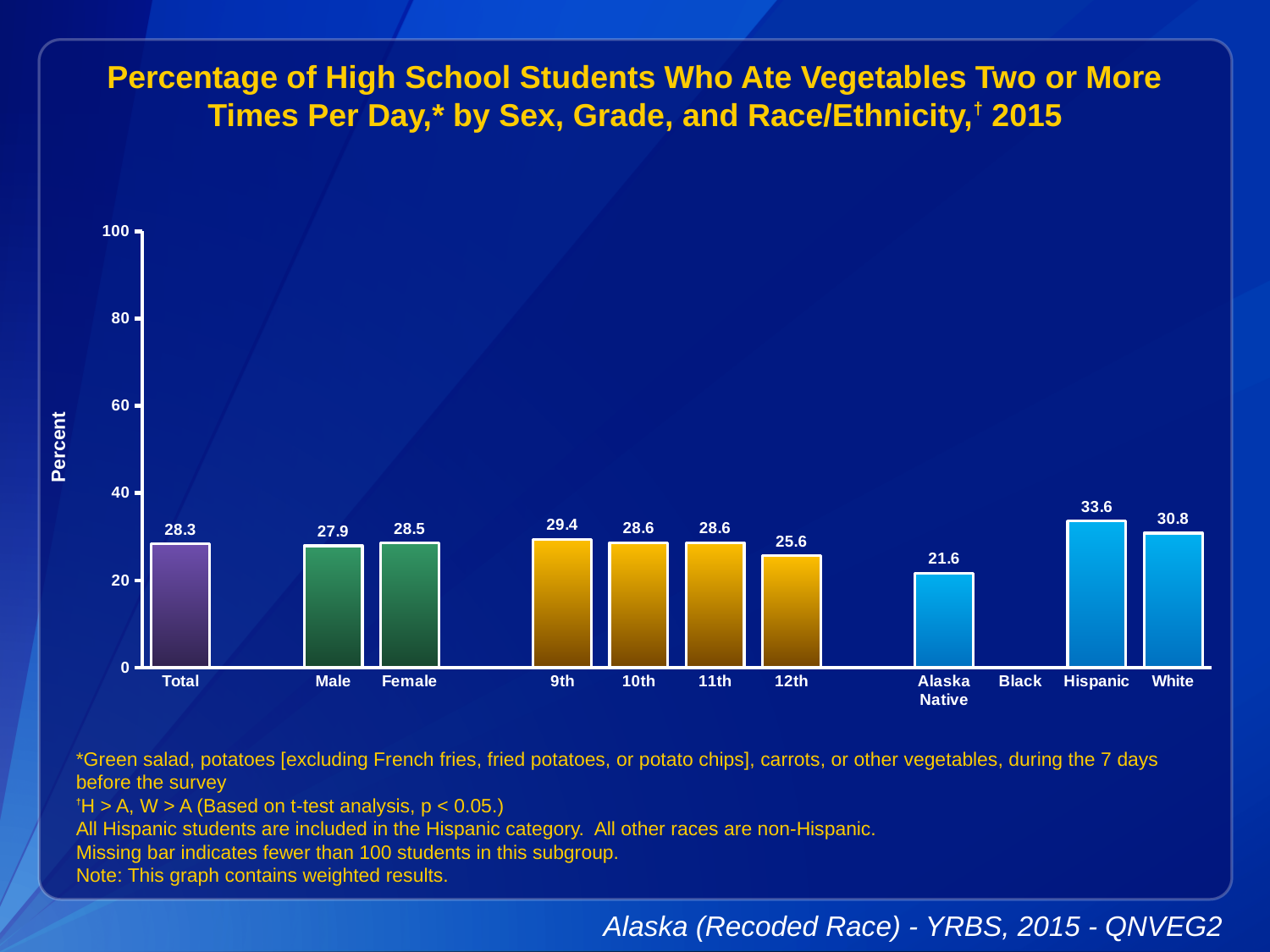
Which race/ethnicity category has no bar shown? Black Is the value for Hispanic greater or less than 40? less Which category has the lowest value among the bars shown? Alaska Native What kind of chart is shown on the slide? bar chart What is the value for 12th grade? 25.6 What is the value for Female? 28.5 What is the value for Alaska Native? 21.6 What is the value for Total? 28.3 Which is larger, the value for 9th grade or the value for 12th grade? 9th What is the difference between the values for Female and Male? 0.6 Which category has the highest value? Hispanic What is the difference between the values for Hispanic and White? 2.8